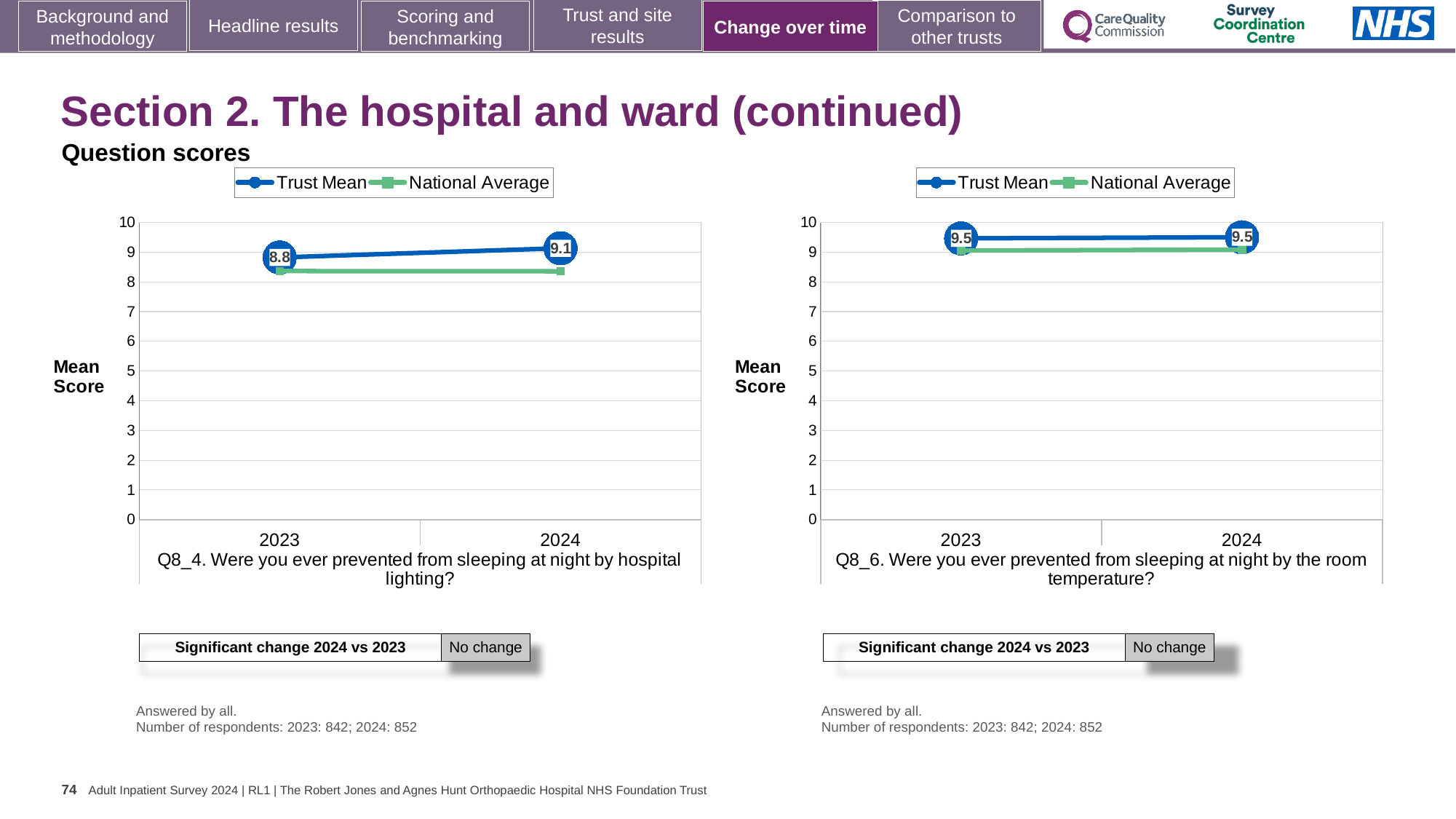
How many series does the legend of the Q8_6 chart on the right list? 2 In the Q8_4 chart on the left, does the Trust Mean rise or fall from 2023 to 2024? rise In the Q8_6 chart on the right, what is the Trust Mean for 2023? 9.5 In the Q8_6 chart on the right, does the Trust Mean rise, fall or stay the same from 2023 to 2024? stay the same In the Q8_4 chart on the left, is the National Average for 2024 greater or less than 9? less In the Q8_4 chart on the left, what is the Trust Mean for 2024? 9.1 In the Q8_4 chart on the left, by how much did the Trust Mean change from 2023 to 2024? 0.3 How many years are plotted on the x axis of the Q8_6 chart on the right? 2 In the Q8_4 chart on the left, which is higher in 2024, the Trust Mean or the National Average? Trust Mean What kind of chart is the Q8_4 chart on the left? line chart In the Q8_6 chart on the right, is the National Average for 2023 greater or less than 8? greater In the Q8_4 chart on the left, what is the Trust Mean for 2023? 8.8